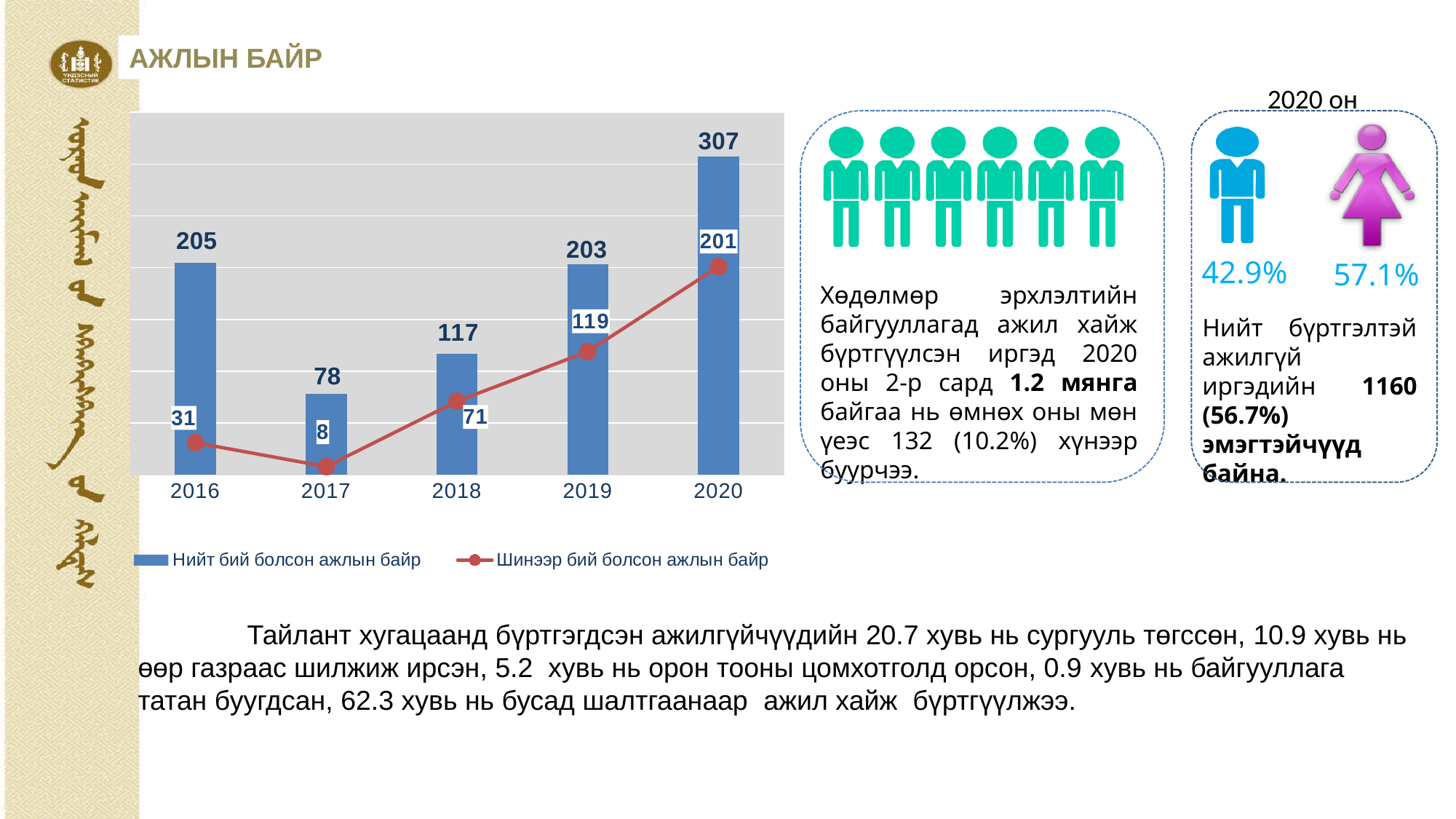
What is the value of Шинээр бий болсон ажлын байр for 2017? 8 Which series is drawn as a red line with markers in the chart? Шинээр бий болсон ажлын байр What is the value of Нийт бий болсон ажлын байр for 2018? 117 How many years are shown on the x axis of the chart? 5 Does Шинээр бий болсон ажлын байр rise or fall from 2017 to 2020? rise What is the value of Шинээр бий болсон ажлын байр for 2019? 119 Which year has the highest value of Нийт бий болсон ажлын байр? 2020 How many series does the chart legend list? 2 Which is larger: Нийт бий болсон ажлын байр in 2016 or in 2019? 2016 Which year has the lowest value of Шинээр бий болсон ажлын байр? 2017 What is the difference between Нийт бий болсон ажлын байр and Шинээр бий болсон ажлын байр in 2020? 106 What is the value of Нийт бий болсон ажлын байр for 2020? 307